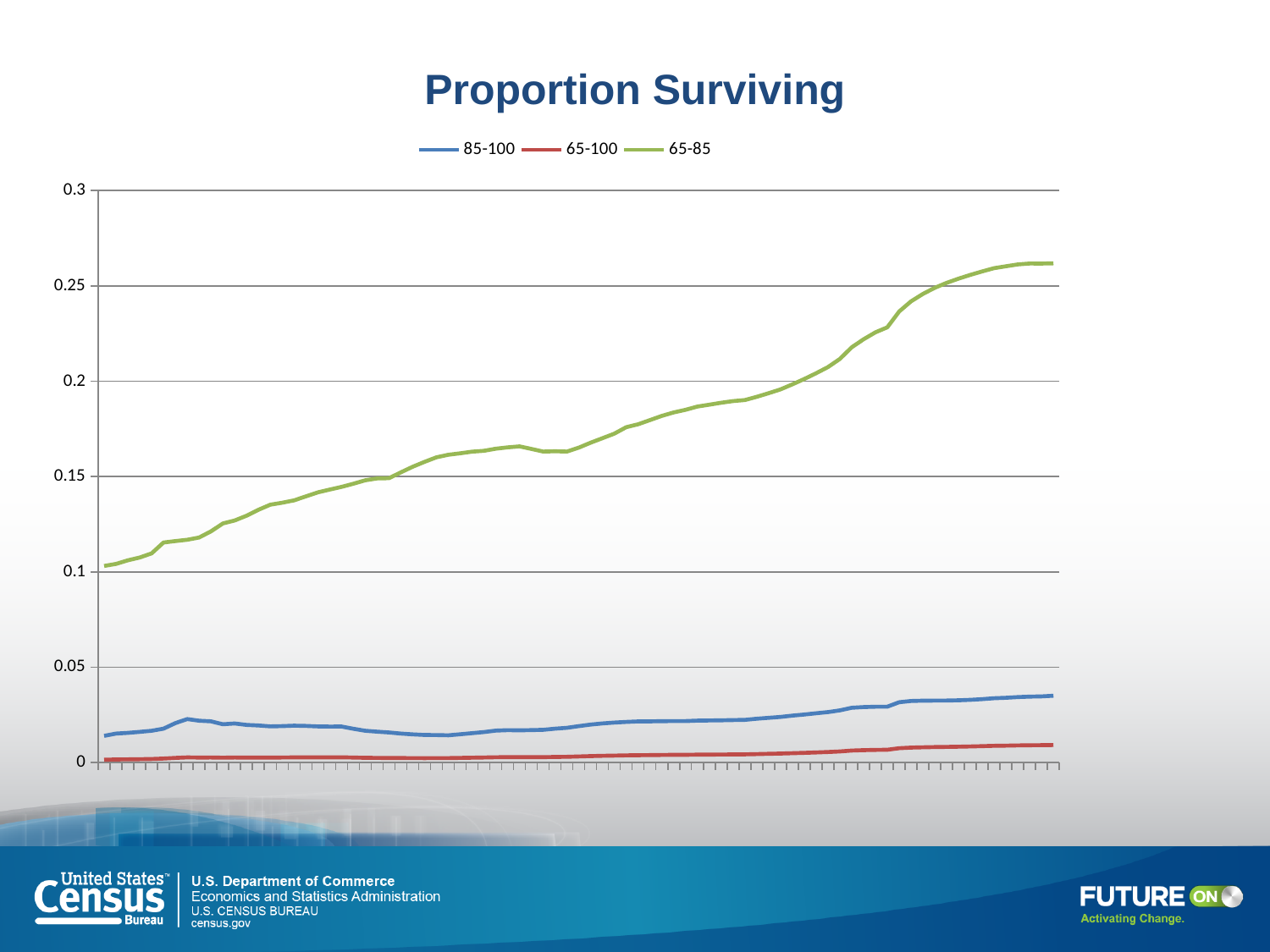
Which series has larger values, 85-100 or 65-100? 85-100 Which series has the highest values across the chart? 65-85 Is the highest value of the 65-85 series greater or less than 0.3? less How many series does the legend list? 3 Which series has the lowest values across the chart? 65-100 Is the highest value of the 85-100 series greater or less than 0.05? less Does the 65-85 series generally rise or fall along the x axis? Rise What is the title of the chart? Proportion Surviving Is the final value of the 65-85 series greater or less than 0.25? greater What kind of chart is shown on the slide? Line chart Which series is drawn in green? 65-85